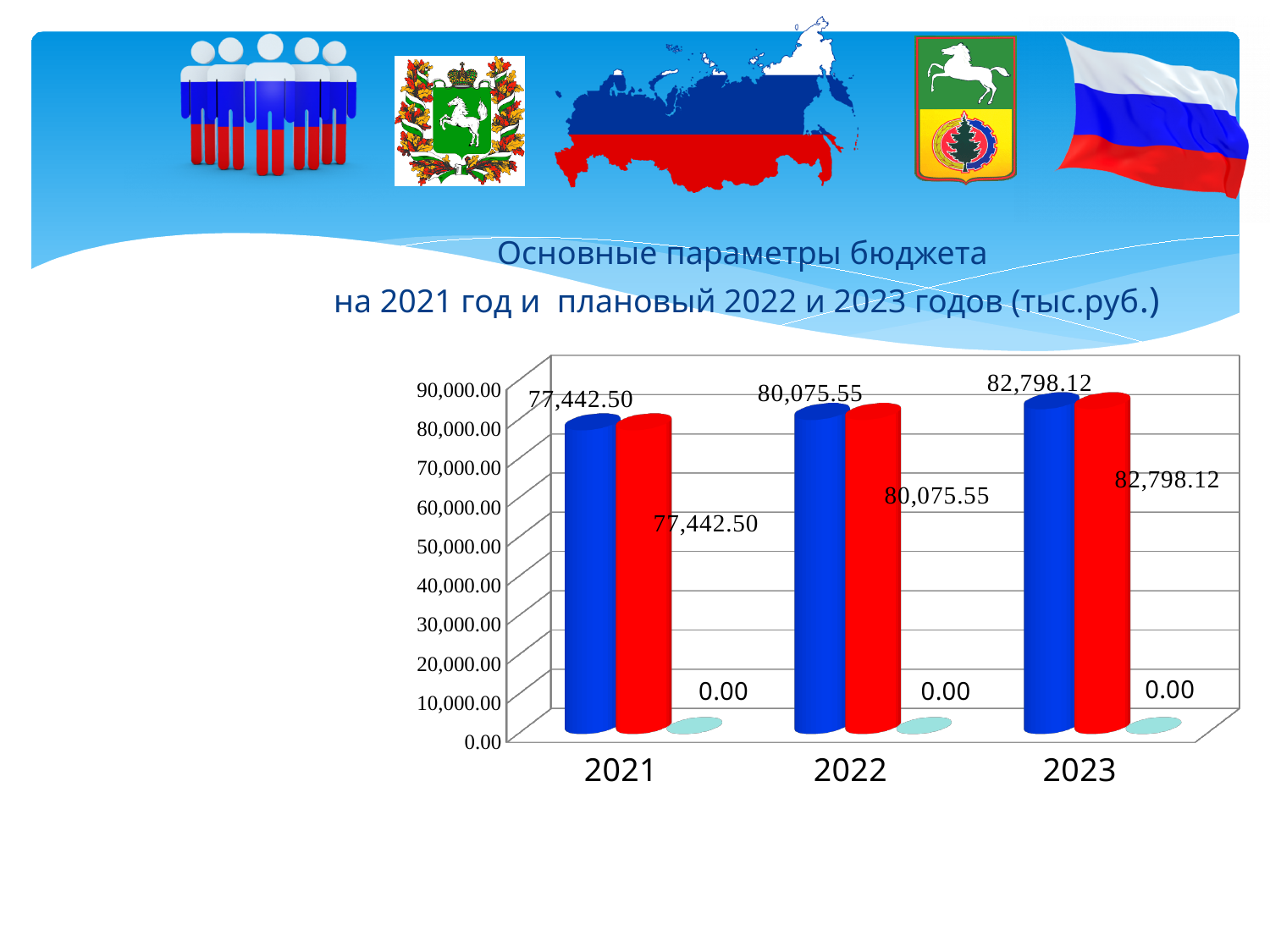
What is the difference between the blue bar values for 2023 and 2021? 5,355.62 What kind of chart is shown on the slide? bar chart Which year has the lowest value for the red bars? 2021 How many years are shown on the x axis? 3 What is the value of the red bar for 2022? 80,075.55 What value is labelled for the third (light teal) series in each year? 0.00 What is the value of the blue bar for 2021? 77,442.50 Which is larger, the blue bar for 2022 or the blue bar for 2021? 2022 What is the value of the blue bar for 2023? 82,798.12 What is the difference between the red bar values for 2022 and 2021? 2,633.05 Do the blue bar values rise or fall from 2021 to 2023? rise Which year has the highest value for the blue bars? 2023